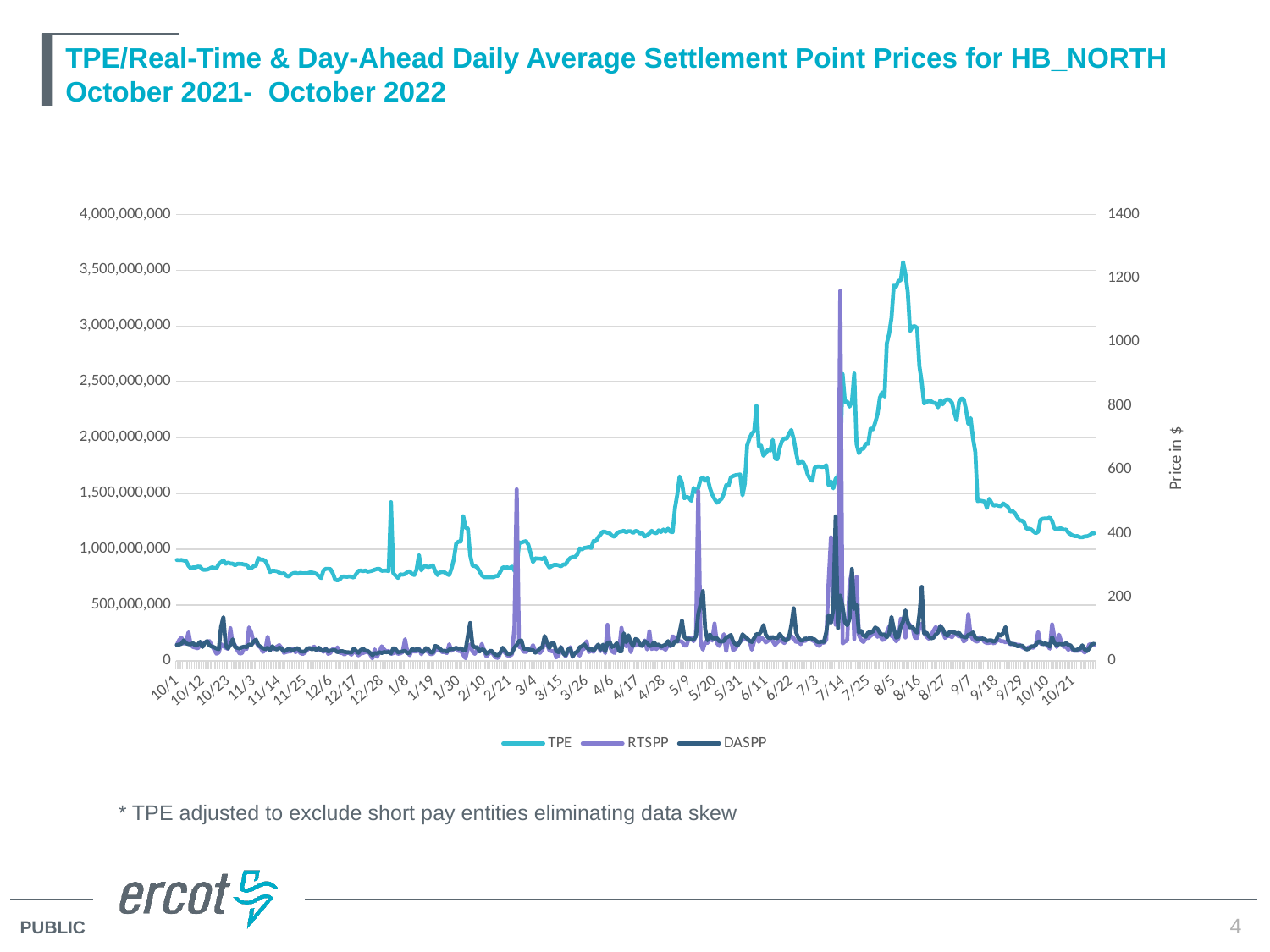
Is the peak value of the TPE line (around 8/5) greater or less than 3,000,000,000? greater What is the label of the right-hand vertical axis? Price in $ Which series are listed in the chart legend? TPE, RTSPP, DASPP Which series reaches a higher peak on the right-hand price axis, RTSPP or DASPP? RTSPP Does the TPE line rise or fall between 8/27 and 10/21? Fall Is the peak of the DASPP line (around 7/14) greater or less than 600 on the right axis? less What is the highest tick value shown on the right vertical axis? 1400 How many series does the legend list? 3 Is the TPE value around 12/6 greater or less than 1,000,000,000? less What is the highest tick value shown on the left vertical axis? 4,000,000,000 What kind of chart is shown on the slide? Line chart